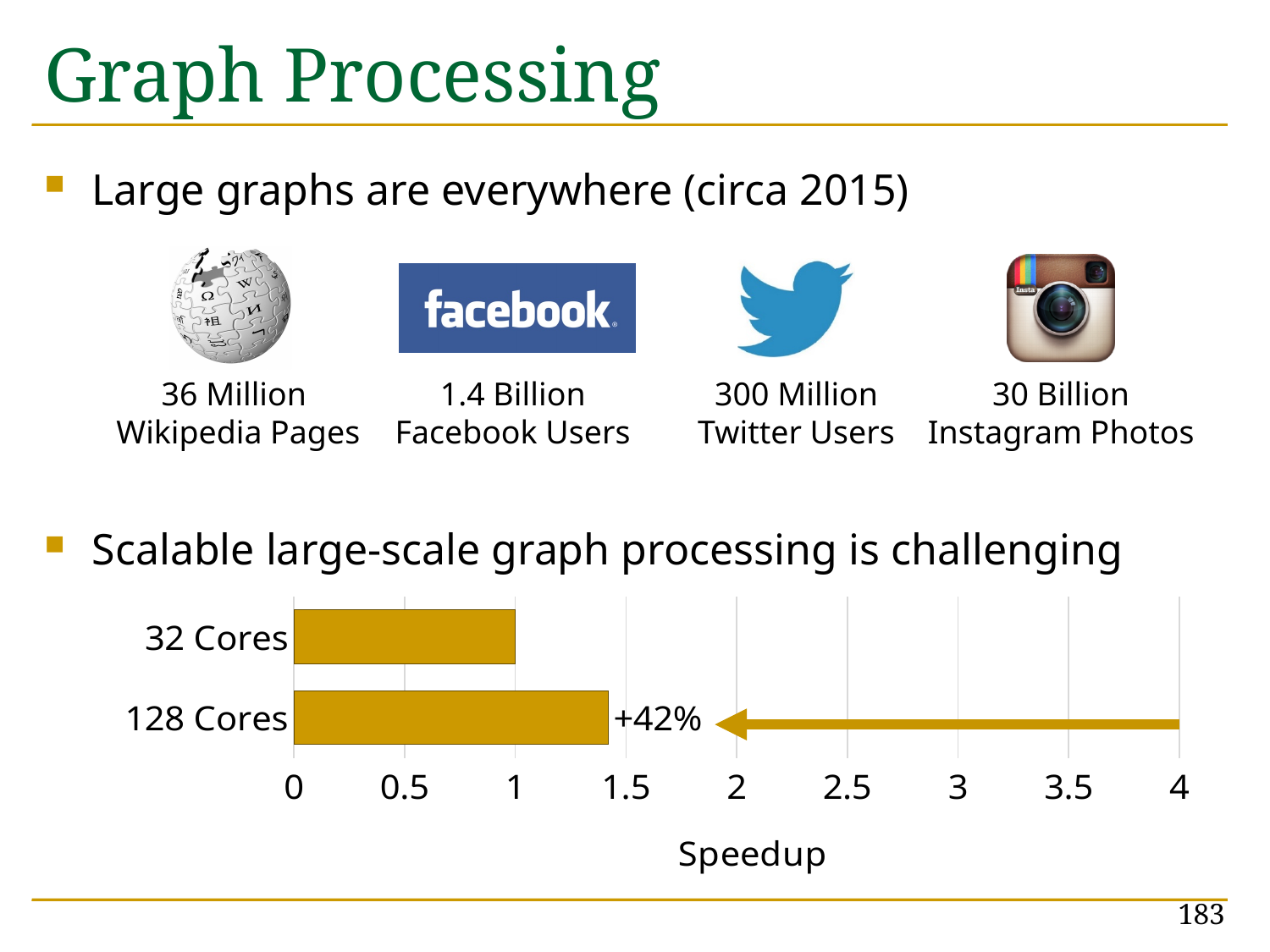
What is the speedup value for 32 Cores in the bar chart? 1 How many categories are plotted in the Speedup bar chart? 2 Is the speedup for 128 Cores greater or less than 2? less Is the speedup for 128 Cores greater or less than 1? greater What annotation is printed next to the 128 Cores bar? +42% Is the speedup for 32 Cores greater or less than 2? less What is the title of the x axis in the bar chart? Speedup Which category has the lowest speedup in the bar chart? 32 Cores What kind of chart is shown at the bottom of the slide? bar chart Which category has the highest speedup in the bar chart? 128 Cores Which has the larger speedup, 32 Cores or 128 Cores? 128 Cores